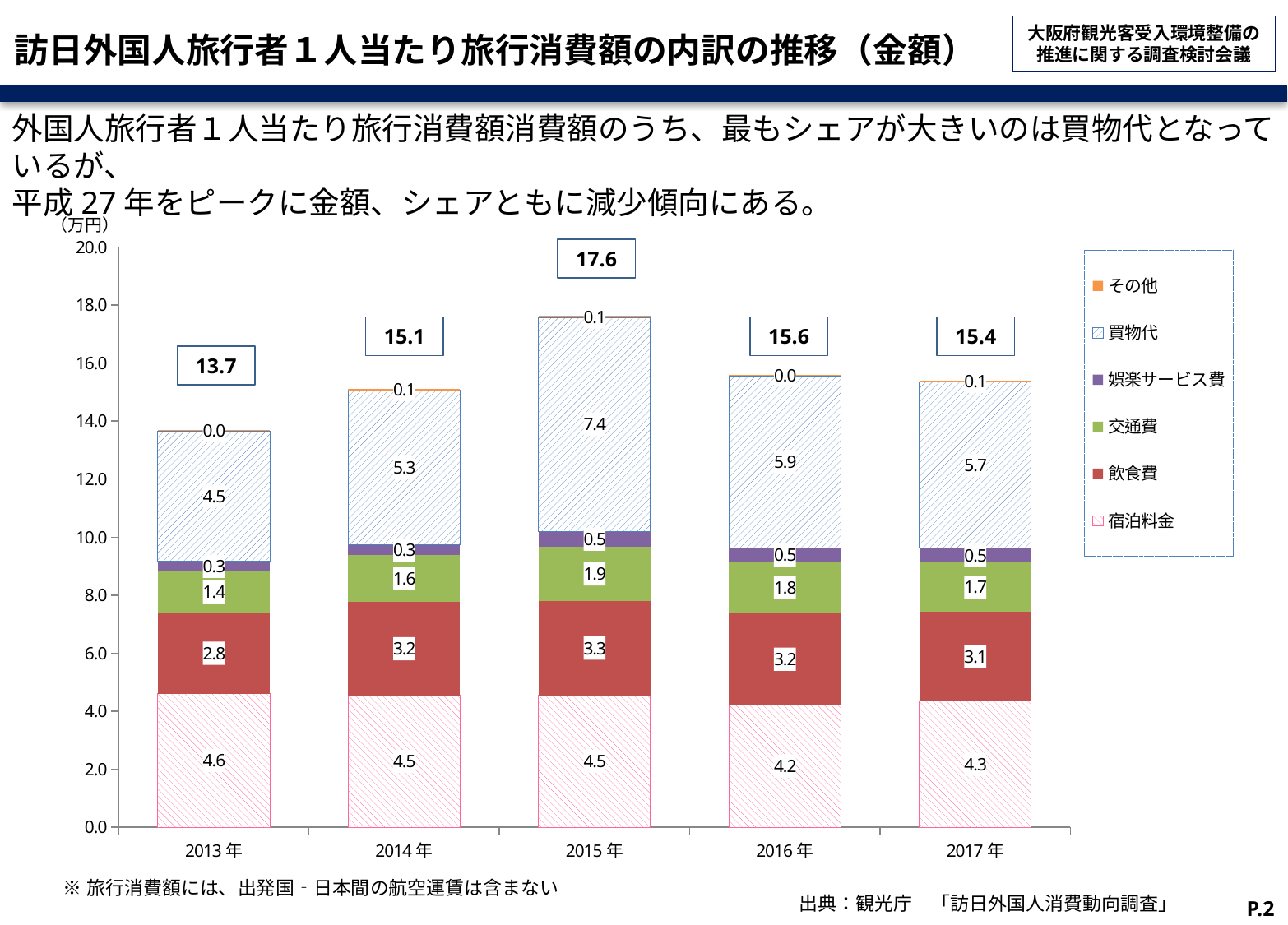
What is the value of 宿泊料金 for 2016年? 4.2 How many series does the legend list? 6 Which year has the highest total per-person travel spending? 2015年 What is the total of the stacked bar for 2016年? 15.6 What is the difference between the 買物代 values for 2015年 and 2017年? 1.7 How many years are shown on the x axis? 5 What is the value of 飲食費 for 2014年? 3.2 What is the value of 買物代 for 2015年? 7.4 Which year has the lowest total per-person travel spending? 2013年 What kind of chart is shown on the slide? Stacked bar chart Which is larger, the 宿泊料金 value for 2013年 or for 2017年? 2013年 What is the value of 交通費 for 2017年? 1.7